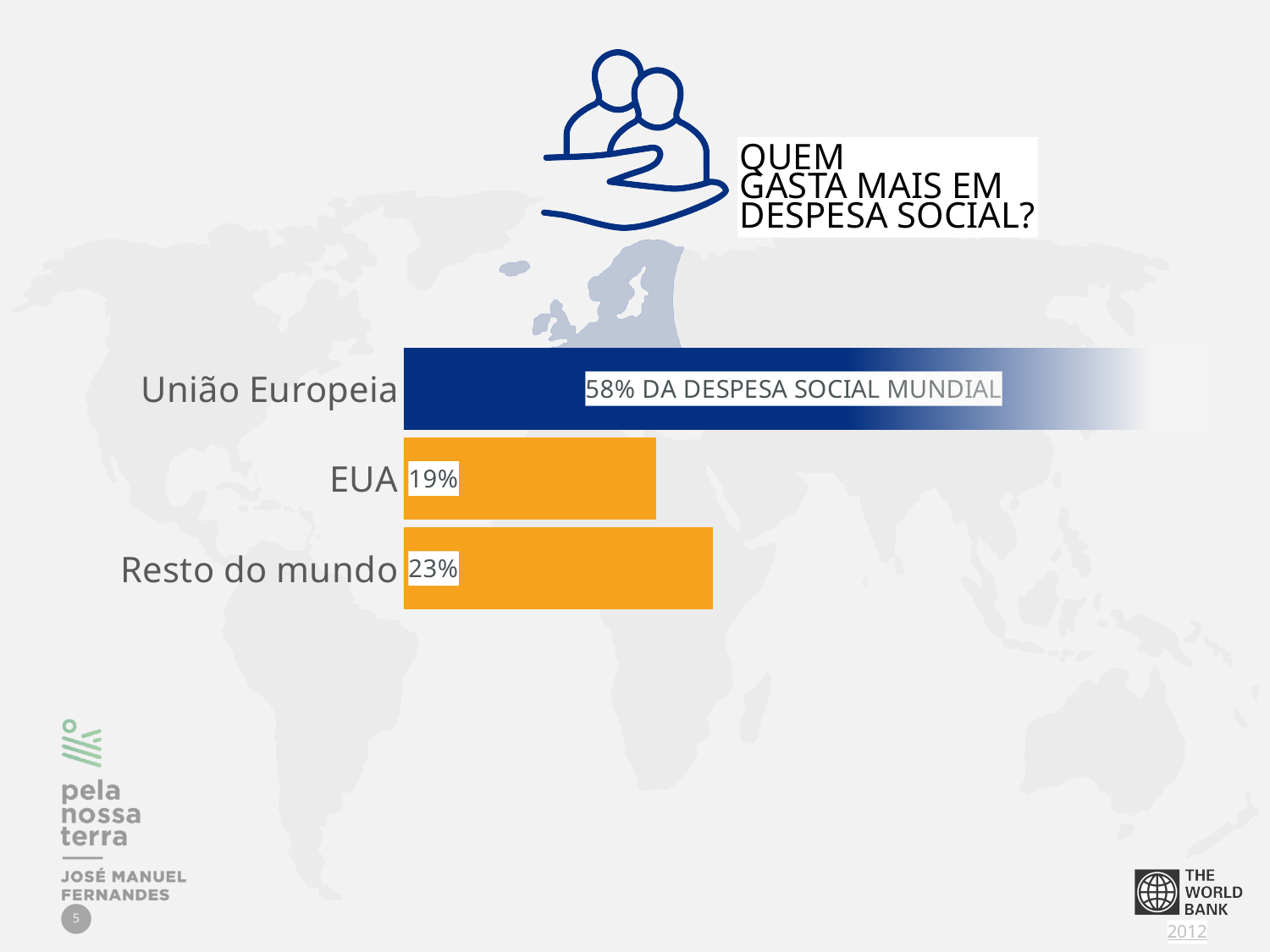
What is the title question shown above the chart? QUEM GASTA MAIS EM DESPESA SOCIAL? How many categories does the chart show? 3 What is the difference between the values for União Europeia and EUA? 39% What value is shown for Resto do mundo? 23% What kind of chart is shown on the slide? Bar chart What share of world social spending does the chart show for União Europeia? 58% Which is larger, the value for EUA or the value for Resto do mundo? Resto do mundo What value is shown for EUA? 19% What is the difference between the values for Resto do mundo and EUA? 4% Which category has the lowest value? EUA Which category has the highest value? União Europeia What colour is the bar for União Europeia? Blue